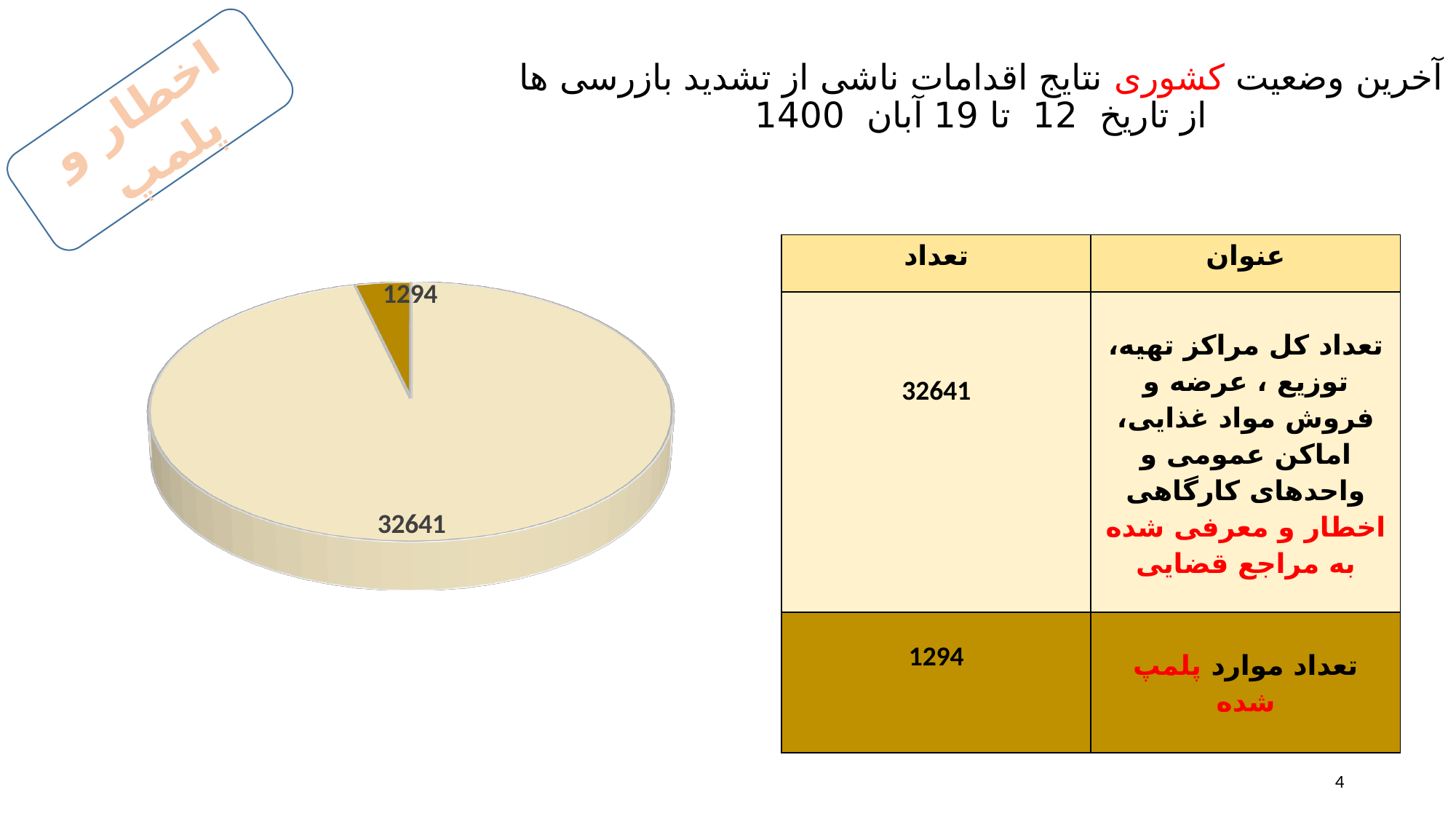
What share of the pie does the slice labelled 1294 represent? 3.8% According to the table next to the pie chart, what value is given for تعداد موارد پلمپ شده? 1294 What is the total of the two slices in the pie chart? 33935 How many slices does the pie chart have? 2 What is the difference between the two slice values in the pie chart? 31347 What is the value of the smaller slice of the pie chart? 1294 Which slice of the pie chart is the smallest? 1294 Is the slice labelled 32641 larger or smaller than the slice labelled 1294? larger Which slice of the pie chart is the largest? 32641 What is the value of the larger slice of the pie chart? 32641 What kind of chart is shown on the slide? pie chart What colour is the smaller slice (1294) of the pie chart? dark gold